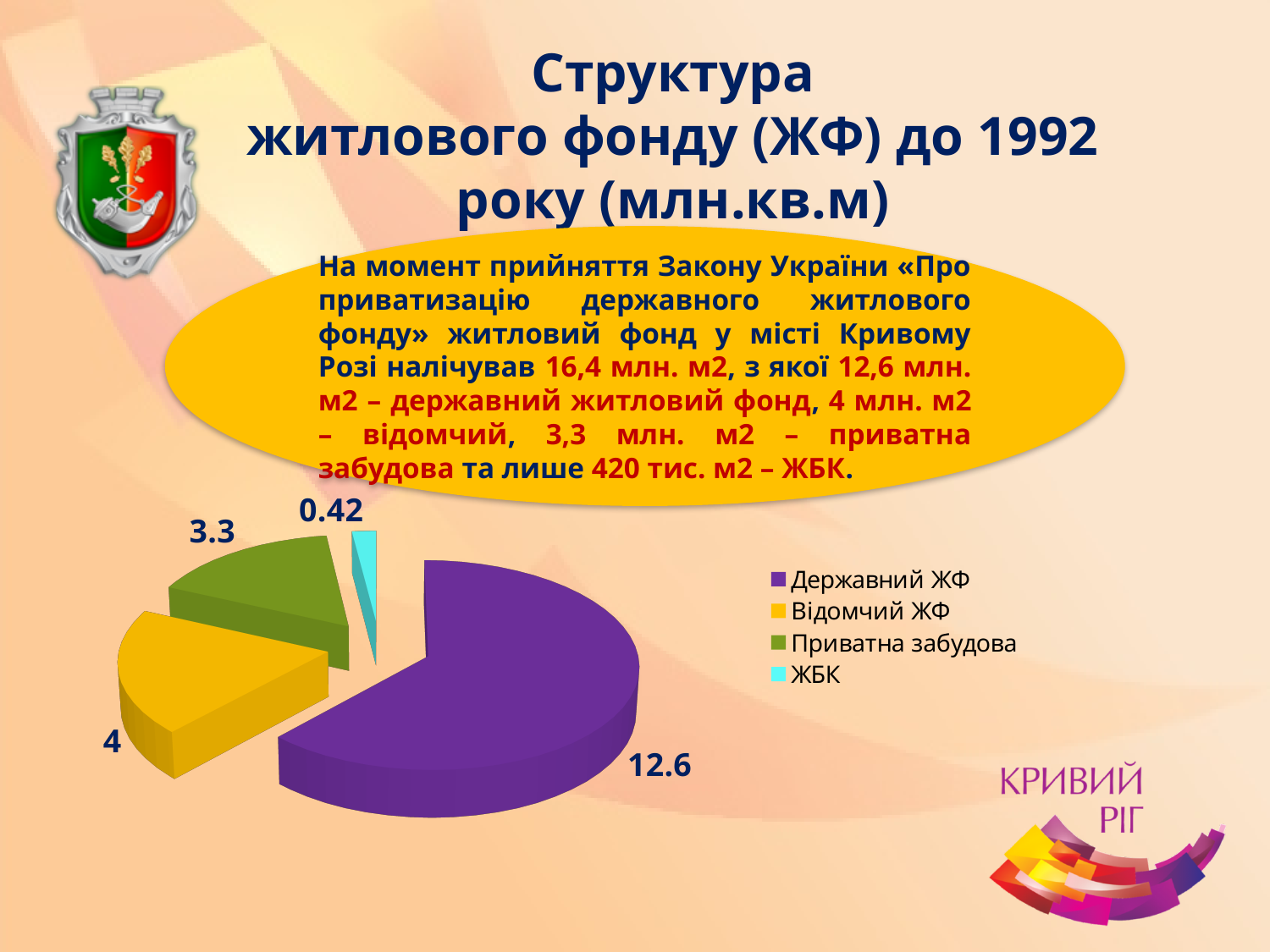
Which category has the smallest slice of the pie? ЖБК What value is shown for the ЖБК slice? 0.42 What colour is the Державний ЖФ slice? Purple What type of chart is shown on the slide? Pie chart What value is shown for the Державний ЖФ slice? 12.6 What value is shown for the Приватна забудова slice? 3.3 Which is larger, Приватна забудова or ЖБК? Приватна забудова What is the difference between the Відомчий ЖФ value and the Приватна забудова value? 0.7 Which category has the largest slice of the pie? Державний ЖФ What value is shown for the Відомчий ЖФ slice? 4 How many slices does the pie chart have? 4 What is the difference between the Державний ЖФ value and the Відомчий ЖФ value? 8.6